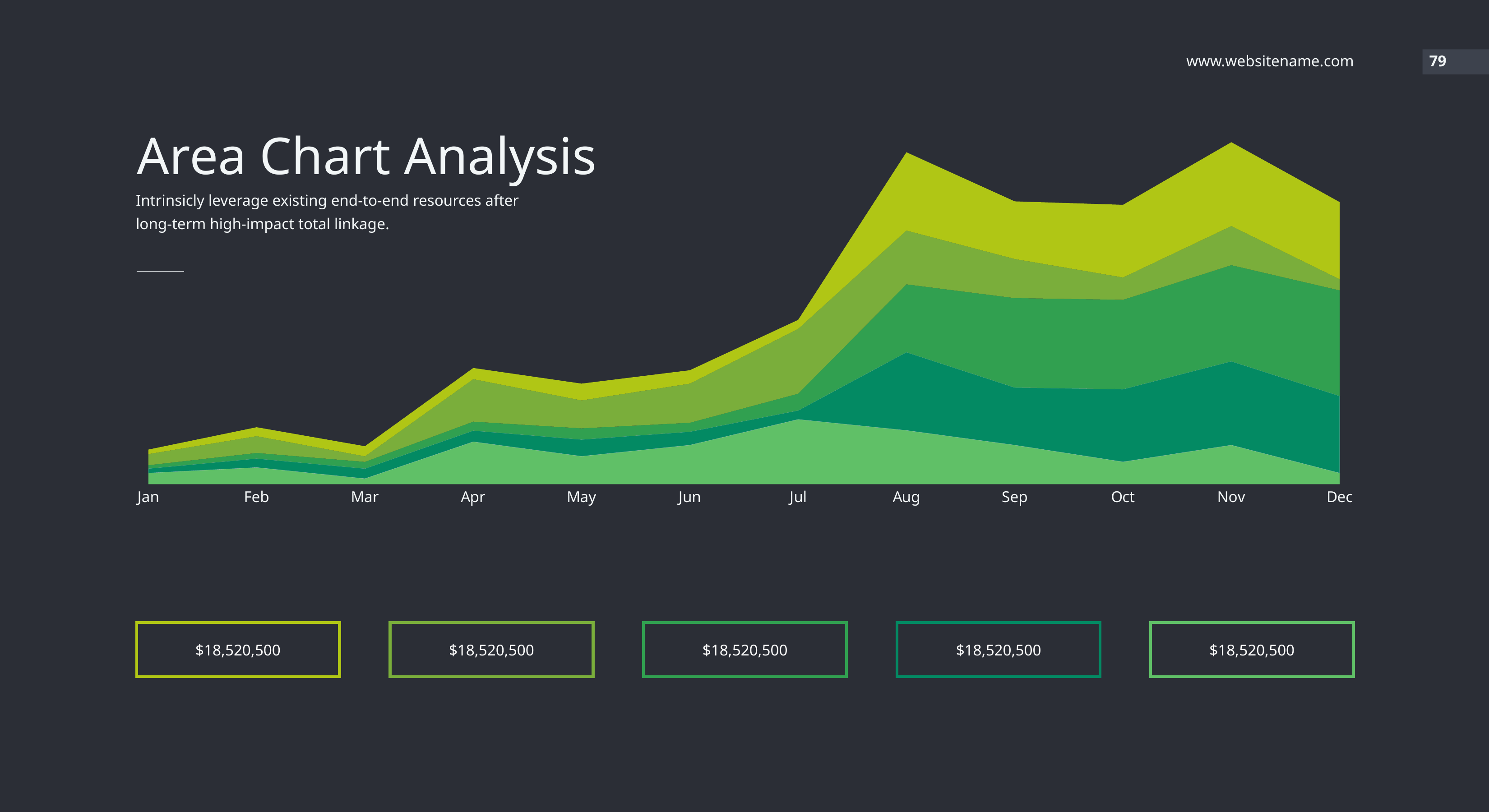
Does the total stacked value rise or fall from Oct to Nov? Rise How many stacked series (colored layers) does the area chart contain? 5 Which is the first month label on the x axis? Jan What is the title of the chart slide? Area Chart Analysis What kind of chart is shown on the slide? Area chart Does the total stacked value generally rise or fall from Jan to Aug? Rise How many months are shown along the x axis of the chart? 12 Is the total stacked value for Aug larger or smaller than the total for Jul? Larger Which month has the larger total stacked value, Apr or Mar? Apr Which month has the larger total stacked value, Dec or Jan? Dec Does the total stacked value rise or fall from Aug to Sep? Fall